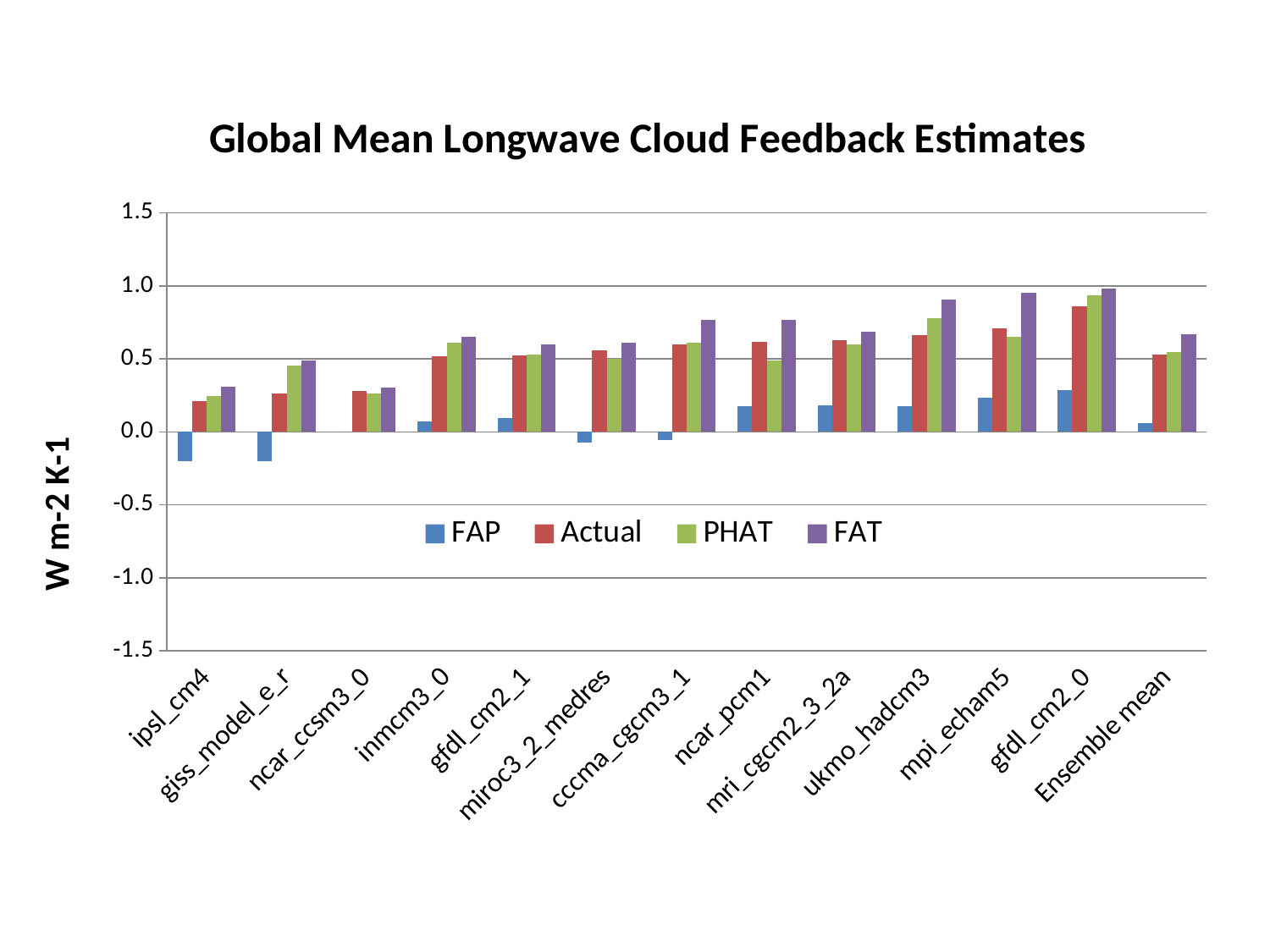
Is the FAP value for ipsl_cm4 greater or less than 0.0? less Which is larger for inmcm3_0, the FAP value or the FAT value? FAT Which category has the highest Actual value? gfdl_cm2_0 How many categories are shown along the x axis? 13 Which category has the highest FAP value? gfdl_cm2_0 Is the FAT value for gfdl_cm2_0 greater or less than 0.5? greater Is the Actual value for ncar_ccsm3_0 greater or less than 0.5? less What kind of chart is shown on the slide? bar chart Do the Actual values generally rise or fall moving from ipsl_cm4 to gfdl_cm2_0 along the x axis? rise How many series does the legend list? 4 What is the label on the vertical axis of the chart? W m-2 K-1 What is the title of the chart? Global Mean Longwave Cloud Feedback Estimates